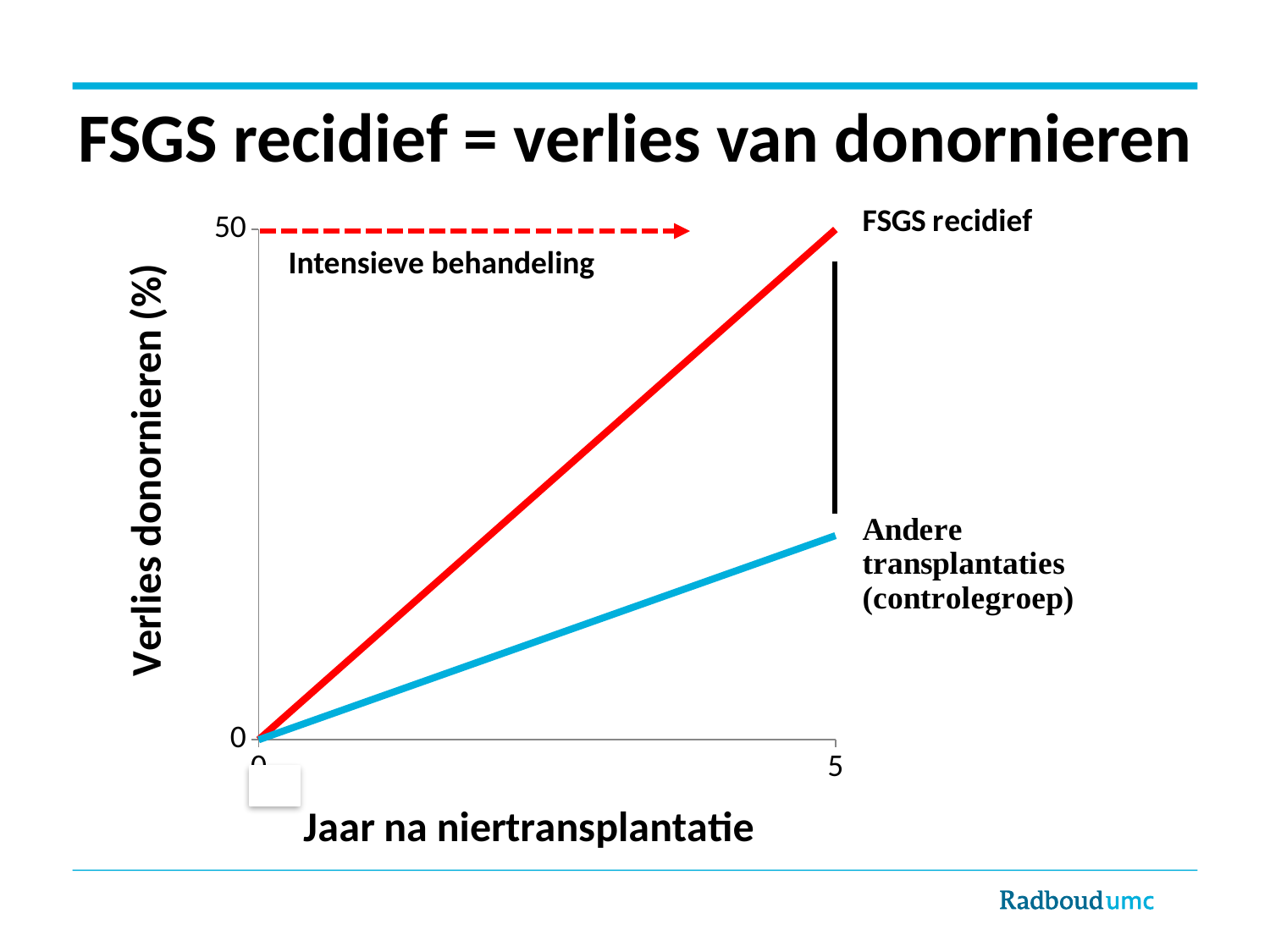
What is the label of the x axis? Jaar na niertransplantatie What is the label of the y axis? Verlies donornieren (%) What kind of chart is shown on the slide? line chart Which series has the lower value at 5 years after kidney transplantation? Andere transplantaties (controlegroep) Is the value for Andere transplantaties (controlegroep) at year 5 greater or less than 50? less Do the values of the FSGS recidief line rise or fall as the years after transplantation increase? rise What is the value for both series at year 0? 0 What is the value for FSGS recidief at year 5? 50 How many lines (series) are plotted on the chart? 2 Do the values of the Andere transplantaties (controlegroep) line rise or fall along the x axis? rise At year 5, is the value for FSGS recidief larger or smaller than the value for Andere transplantaties (controlegroep)? larger Which series has the higher value at 5 years after kidney transplantation? FSGS recidief